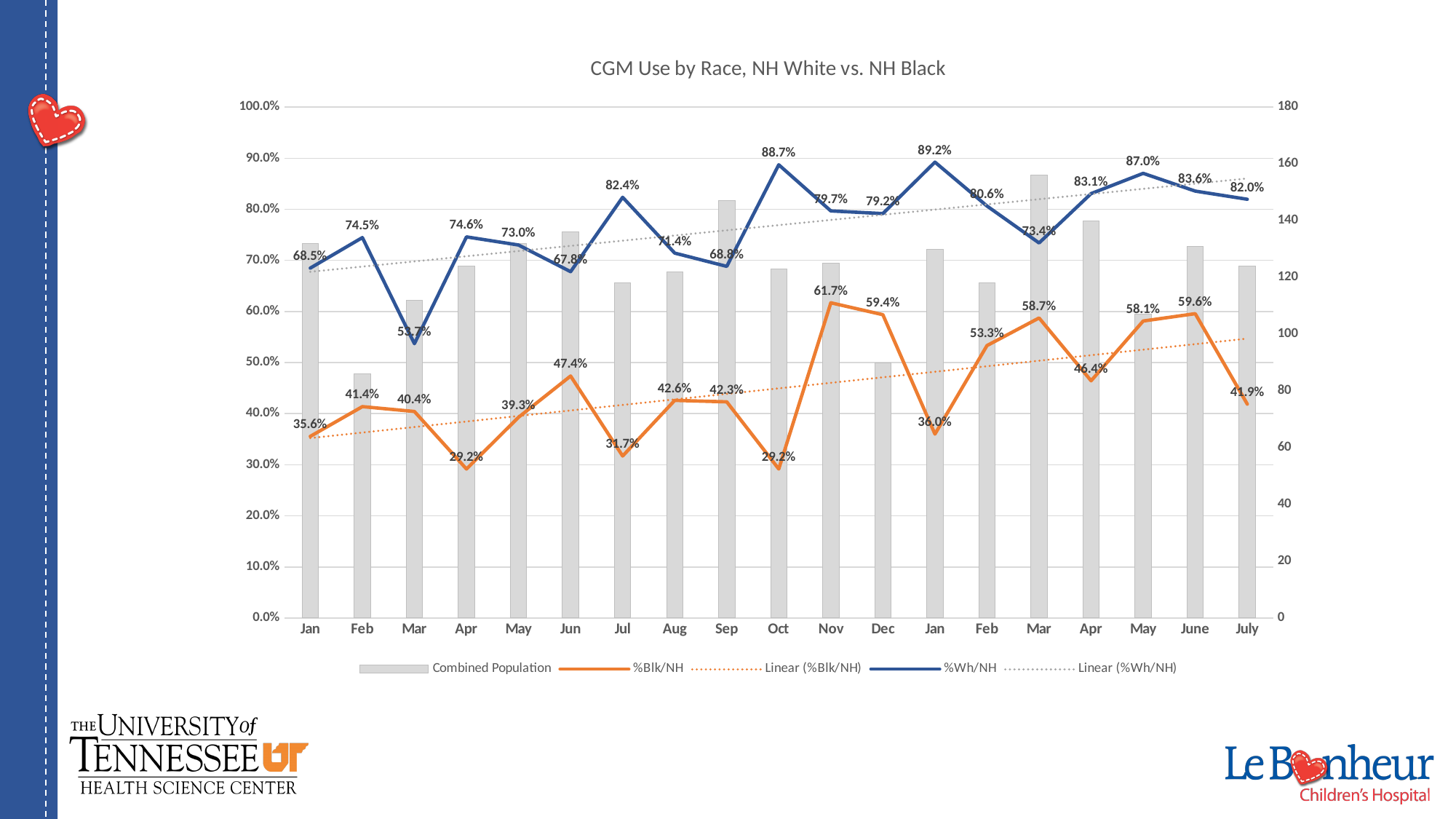
What is the difference between the %Wh/NH and %Blk/NH values in Nov? 18.0 percentage points How many months are shown on the x axis? 19 How many entries does the legend list? 5 Which month has the lowest %Wh/NH value? Mar (the first Mar on the x axis), 53.7% What kind of chart is this? A combined bar and line chart What is the %Blk/NH value for Nov? 61.7% What is the %Wh/NH value for Oct? 88.7% What is the %Blk/NH value for the first Jan on the x axis? 35.6% Which month has the highest %Wh/NH value? Jan (the second Jan on the x axis), 89.2% Is the Combined Population bar for the second Mar on the x axis greater or less than 140? greater Which is larger, the %Wh/NH value for the first Jul or for Oct? Oct Which month has the highest %Blk/NH value? Nov, 61.7%